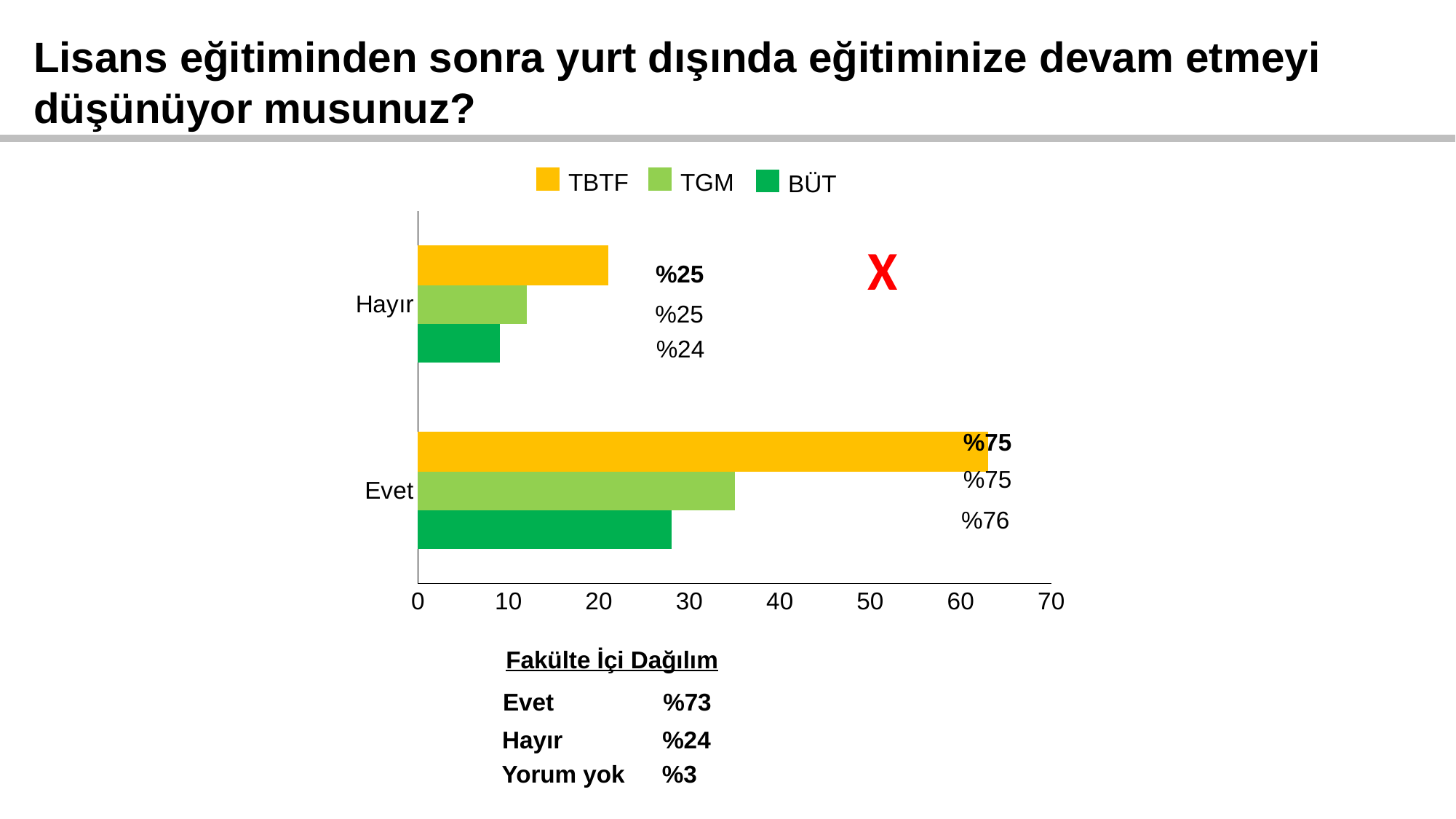
Which series has the longest bar for Evet? TBTF Is the BÜT bar for Evet greater or less than 30? less Is the TBTF bar for Evet greater or less than 60? greater What kind of chart is shown on the slide? bar chart Which bar is longer for Evet, TBTF or TGM? TBTF Is the TGM bar for Evet greater or less than 30? greater How many series does the chart legend list? 3 Which series has the shortest bar for Hayır? BÜT Which series is shown in yellow in the legend? TBTF What percentage label is printed next to the BÜT bar for Evet? %76 How many categories are shown on the chart's vertical axis? 2